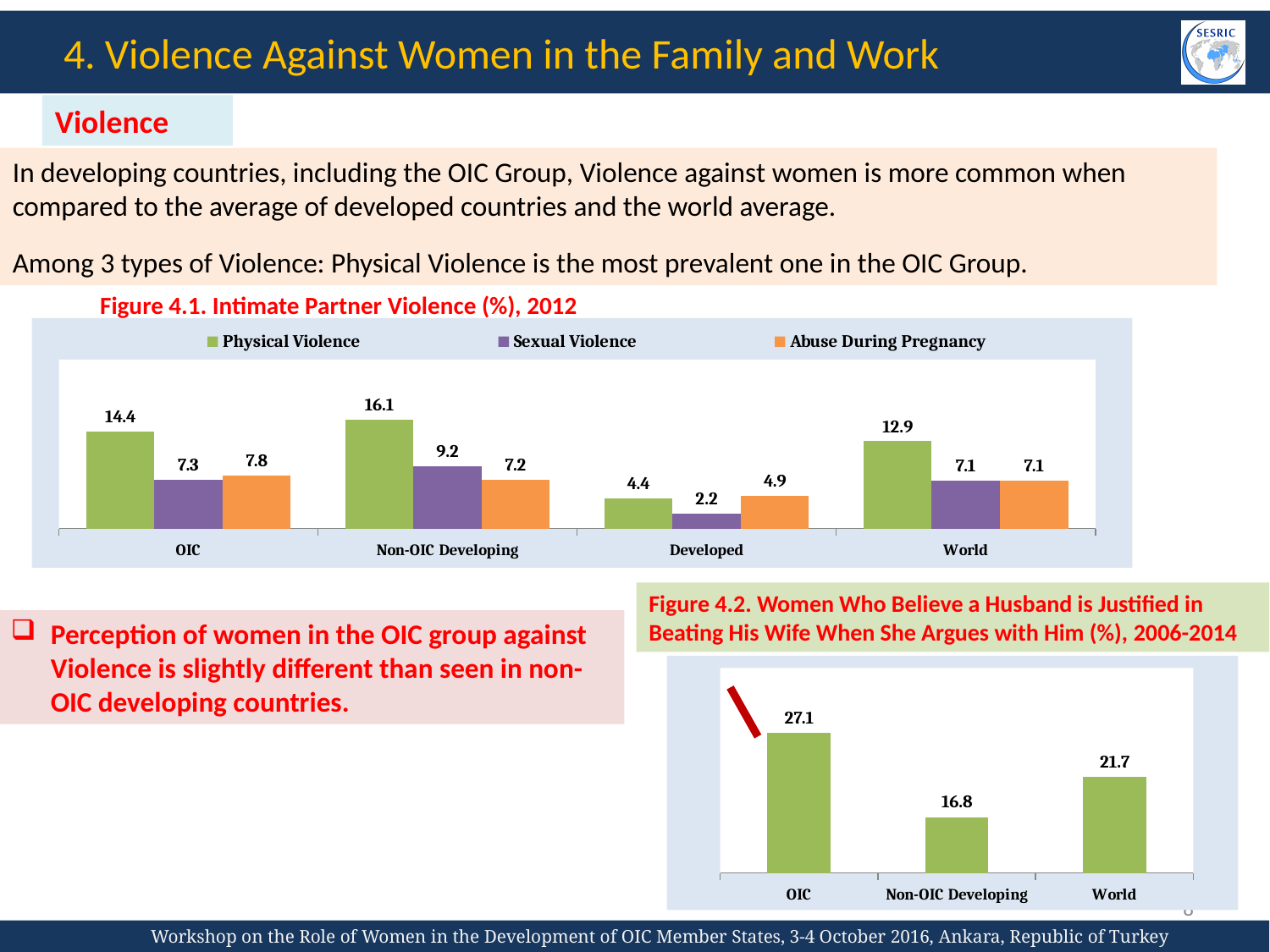
In Figure 4.1, what is the Physical Violence value for the OIC group? 14.4 In Figure 4.2, which category has the highest value? OIC In Figure 4.1, how many categories are shown on the x axis? 4 In Figure 4.1, how many series does the legend list? 3 What kind of chart is Figure 4.2? bar chart In Figure 4.1, what is the Sexual Violence value for Developed countries? 2.2 In Figure 4.1, which category has the highest Physical Violence value? Non-OIC Developing In Figure 4.1, is the Sexual Violence value for OIC larger or smaller than the Sexual Violence value for Non-OIC Developing? smaller In Figure 4.1, which category has the lowest Abuse During Pregnancy value? Developed In Figure 4.1, what is the difference between the Physical Violence values for Non-OIC Developing and OIC? 1.7 In Figure 4.2, what is the value for Non-OIC Developing? 16.8 In Figure 4.2, what is the difference between the values for OIC and World? 5.4